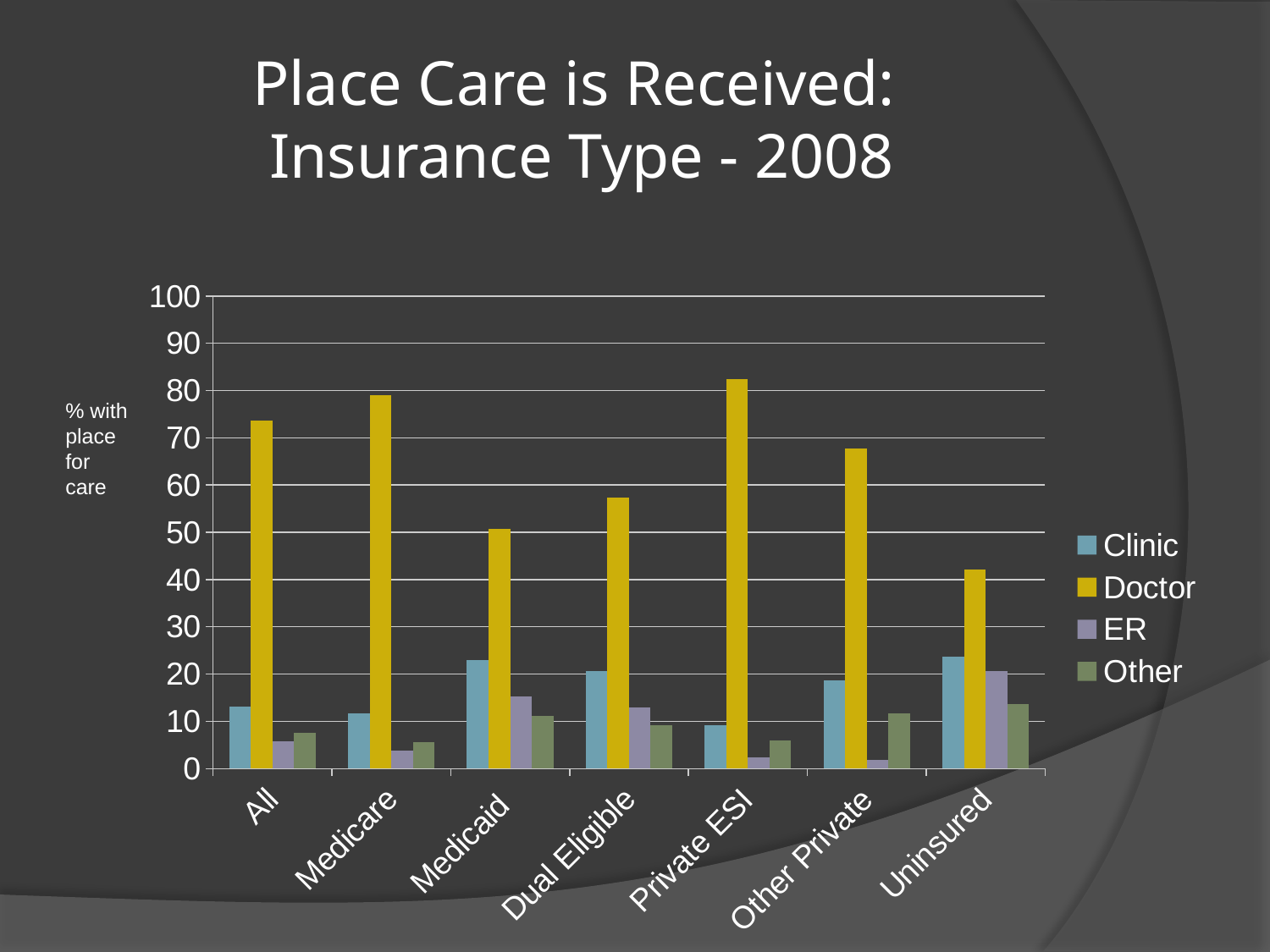
Is the Doctor value for Private ESI greater or less than 80? greater How many insurance type categories are shown on the x axis? 7 Is the Clinic value for Medicaid greater or less than 20? greater Is the Doctor value for Uninsured greater or less than 50? less Which insurance type has the lowest Doctor value? Uninsured How many series does the legend list? 4 What is the title of the chart? Place Care is Received: Insurance Type - 2008 Which insurance type has the highest ER value? Uninsured Which insurance type has the highest Doctor value? Private ESI Which is larger, the Doctor value for Medicare or for Medicaid? Medicare What kind of chart is shown on the slide? bar chart